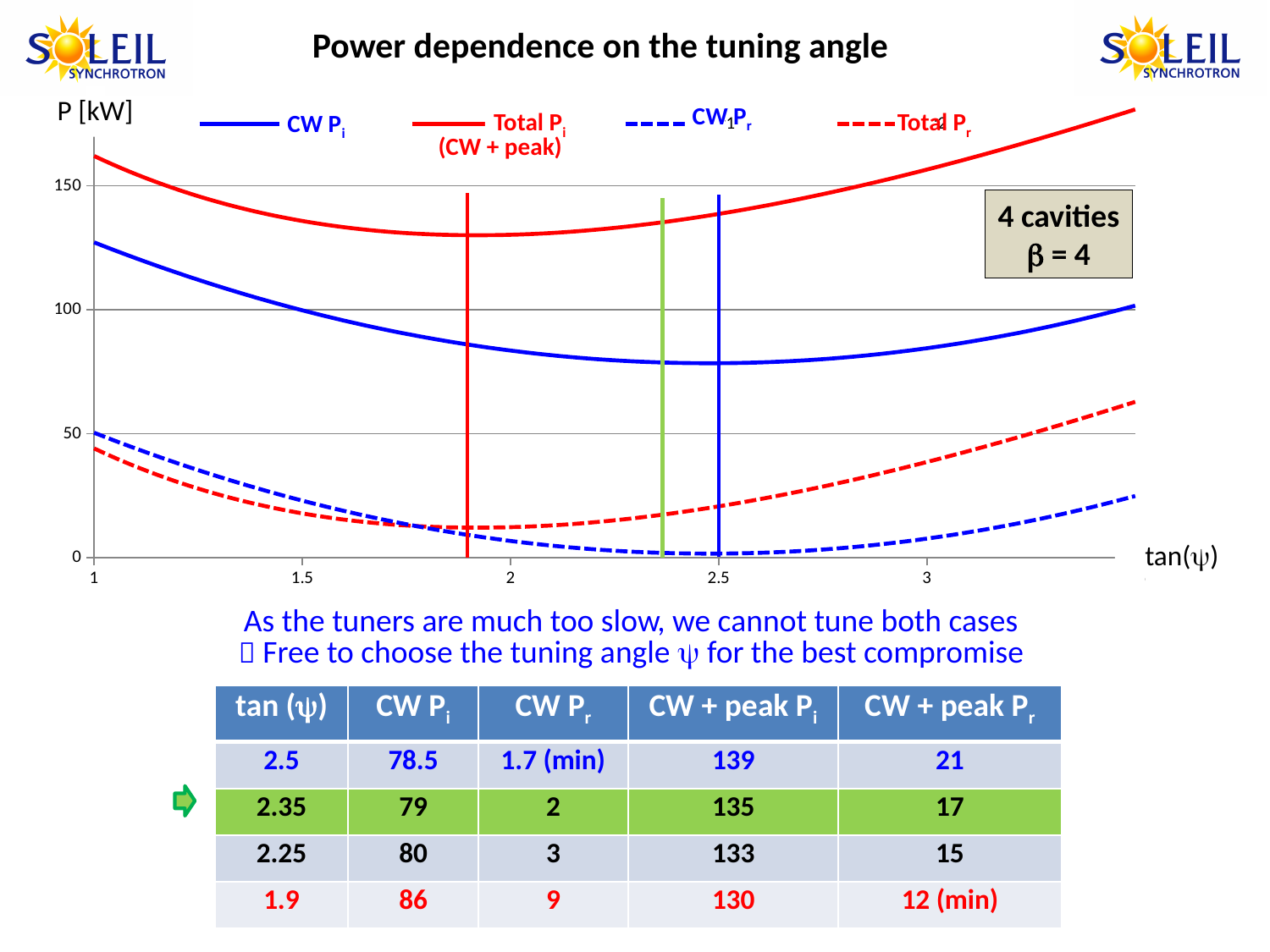
Is the value of CW Pi at tan(ψ) = 1 greater or less than 100? greater Does the Total Pi (CW + peak) curve rise or fall as tan(ψ) increases from 2.5 to 3.5? rise Does the CW Pi curve rise or fall as tan(ψ) increases from 1 to 2? fall At tan(ψ) = 1, which is higher, CW Pi or Total Pi (CW + peak)? Total Pi (CW + peak) At tan(ψ) = 3, which is higher, Total Pr or CW Pr? Total Pr What is the title of the chart? Power dependence on the tuning angle What kind of chart is shown on the slide? line chart Is the value of CW Pr at tan(ψ) = 3 greater or less than 50? less How many series does the chart legend list? 4 According to the table below the chart, what is CW Pi at tan(ψ) = 2.5? 78.5 Is the value of Total Pi (CW + peak) at tan(ψ) = 1 greater or less than 150? greater What does the box in the upper right of the chart say? 4 cavities β = 4